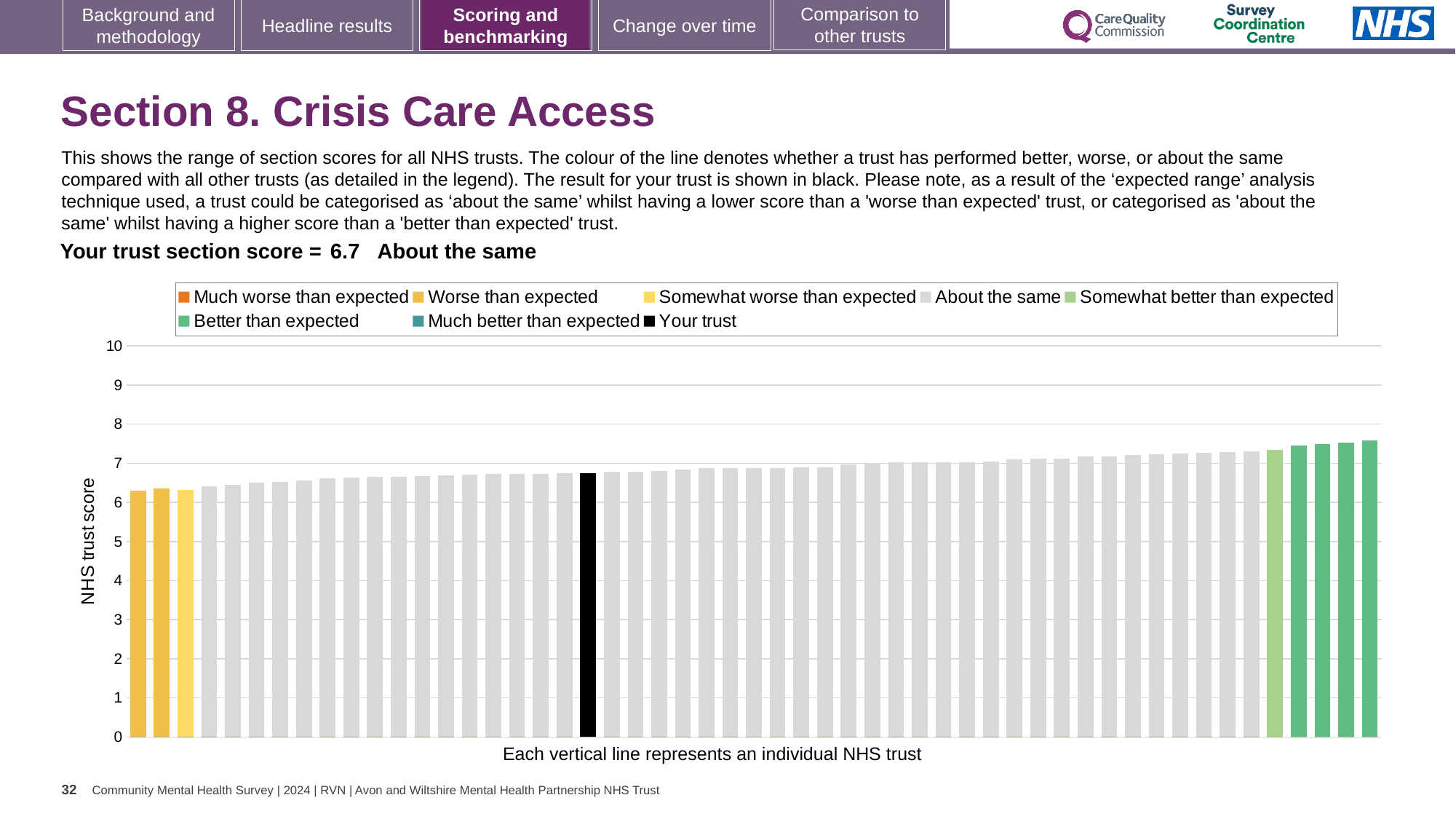
Which performance category is your trust placed in for Section 8? About the same Is the value for your trust's bar greater or less than 6? greater What kind of chart is shown on the slide? bar chart Is the value for your trust's bar greater or less than 7? less How many entries does the chart legend list? 8 What is the section score for your trust shown on the slide? 6.7 What is the label on the vertical axis of the chart? NHS trust score Is the value of the shortest bar greater or less than 6? greater How many bars are coloured as 'Worse than expected'? 2 How many bars are coloured as 'Better than expected'? 4 Do the bar values rise or fall from left to right along the x axis? rise